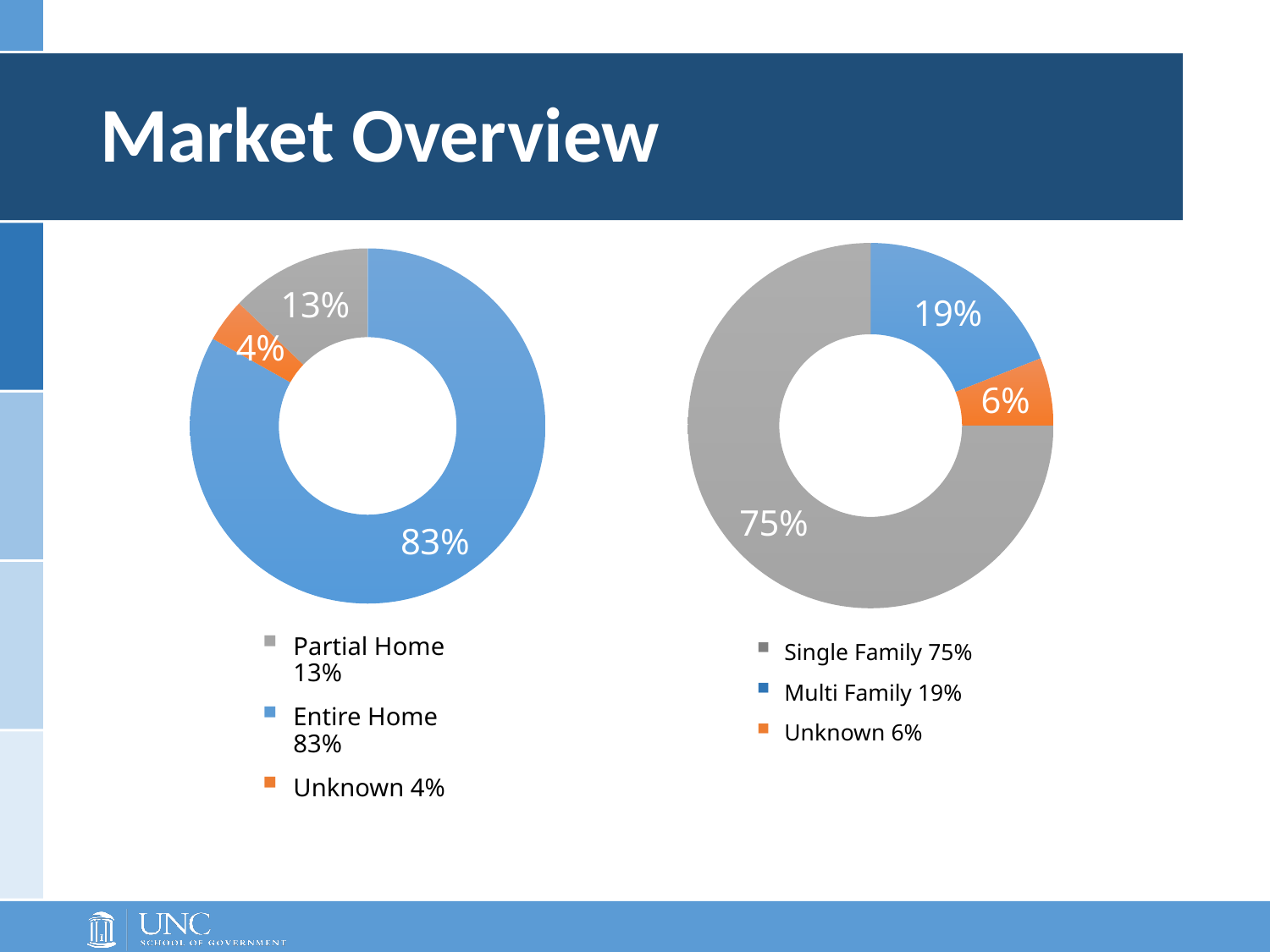
In the left chart, what share does Partial Home have? 13% In the right chart, which category has the smallest share? Unknown In the right chart, what share does Multi Family have? 19% In the right chart, what is the difference between the Single Family and Multi Family shares? 56% In the right chart, which is larger, Single Family or Multi Family? Single Family In the left chart, what share does Entire Home have? 83% How many categories does the left chart's legend list? 3 In the left chart, which category has the largest share? Entire Home What kind of chart is the right chart? Doughnut (pie) chart In the right chart, what colour is the Single Family slice? Gray In the right chart, what share does Unknown have? 6% In the left chart, what is the difference between the Entire Home and Partial Home shares? 70%